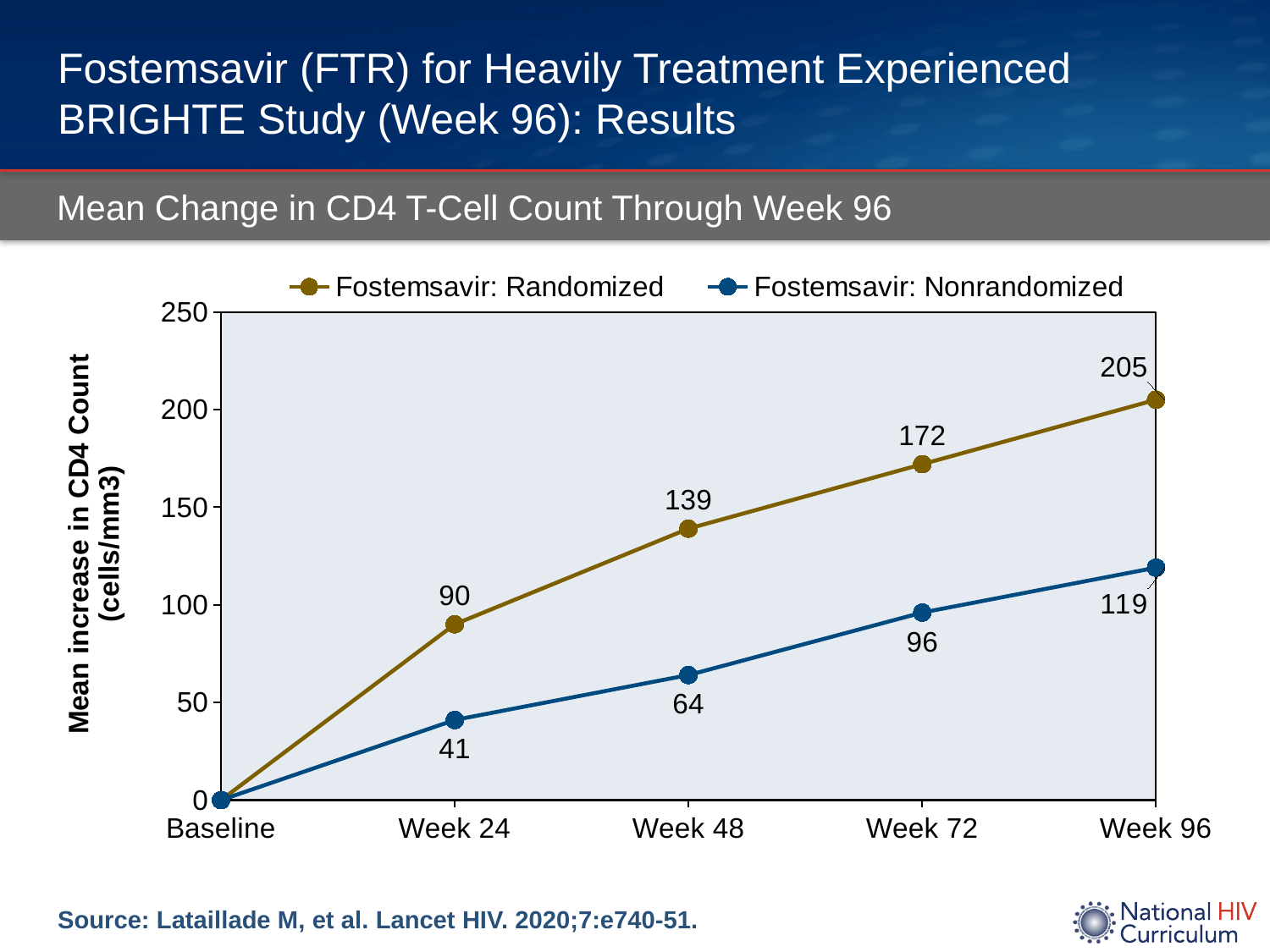
What is the mean increase in CD4 count for Fostemsavir: Randomized at Week 96? 205 What kind of chart is shown on the slide? Line chart What is the value for Fostemsavir: Randomized at Week 24? 90 At which time point does the Fostemsavir: Randomized series reach its highest value? Week 96 What is the mean increase in CD4 count for Fostemsavir: Nonrandomized at Week 48? 64 How many time points are shown on the x axis? 5 Do the values for Fostemsavir: Nonrandomized rise or fall from Baseline to Week 96? Rise What is the difference between the Randomized and Nonrandomized values at Week 96? 86 What is the value for Fostemsavir: Nonrandomized at Week 72? 96 How many series does the legend list? 2 What is the difference between the Randomized values at Week 72 and Week 48? 33 Which series has the larger value at Week 24, Randomized or Nonrandomized? Fostemsavir: Randomized